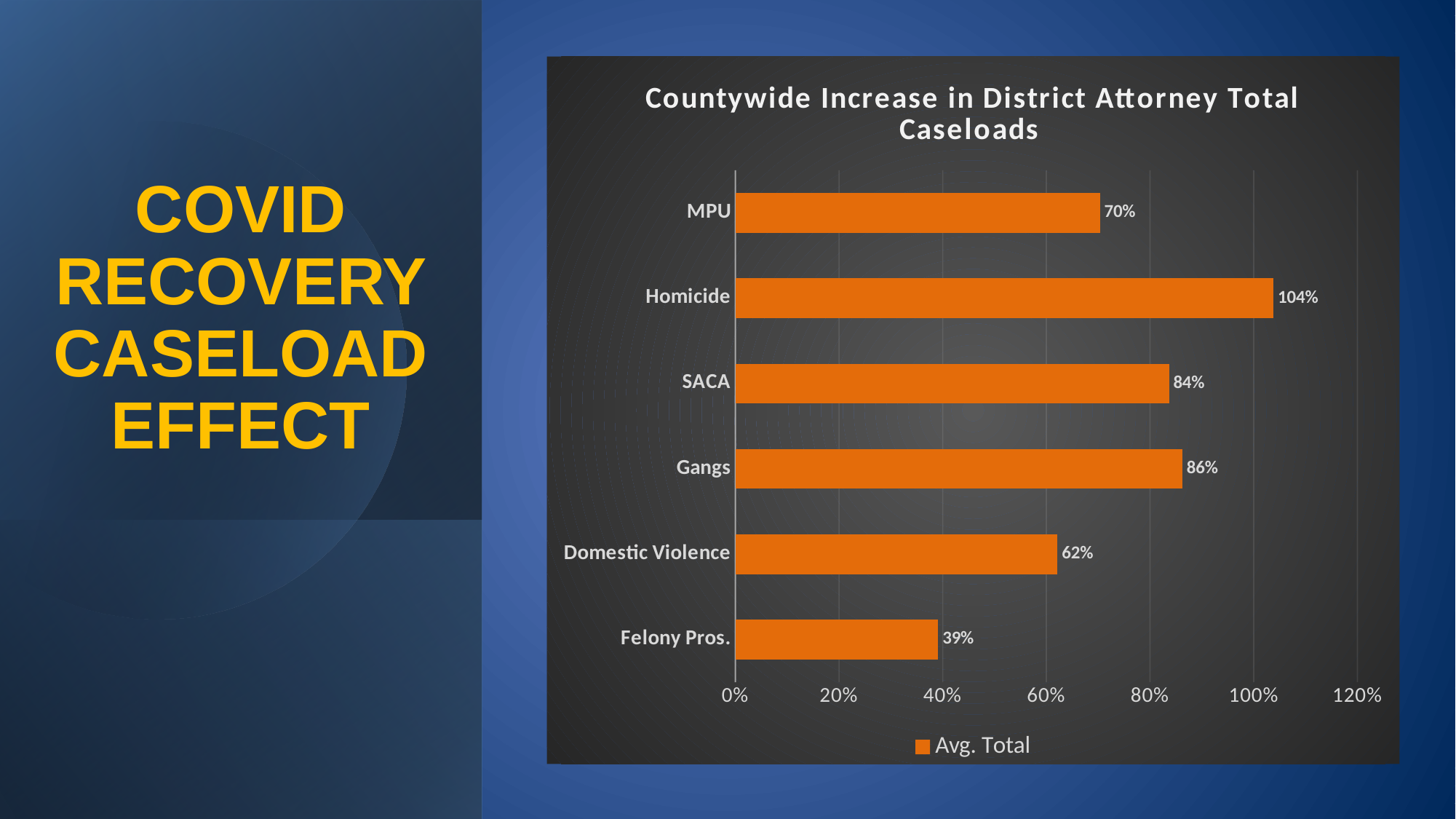
What is the value for Felony Pros.? 39% Which category has the lowest value? Felony Pros. Which category has the highest value? Homicide What is the value for Domestic Violence? 62% Is the value for Gangs greater or less than 80%? greater What kind of chart is shown on the slide? bar chart What is the title of the chart? Countywide Increase in District Attorney Total Caseloads What is the difference between the values for Homicide and MPU? 34% Which is larger, the value for SACA or the value for Domestic Violence? SACA How many series does the legend list? 1 How many categories are shown on the chart? 6 What is the value for Homicide? 104%